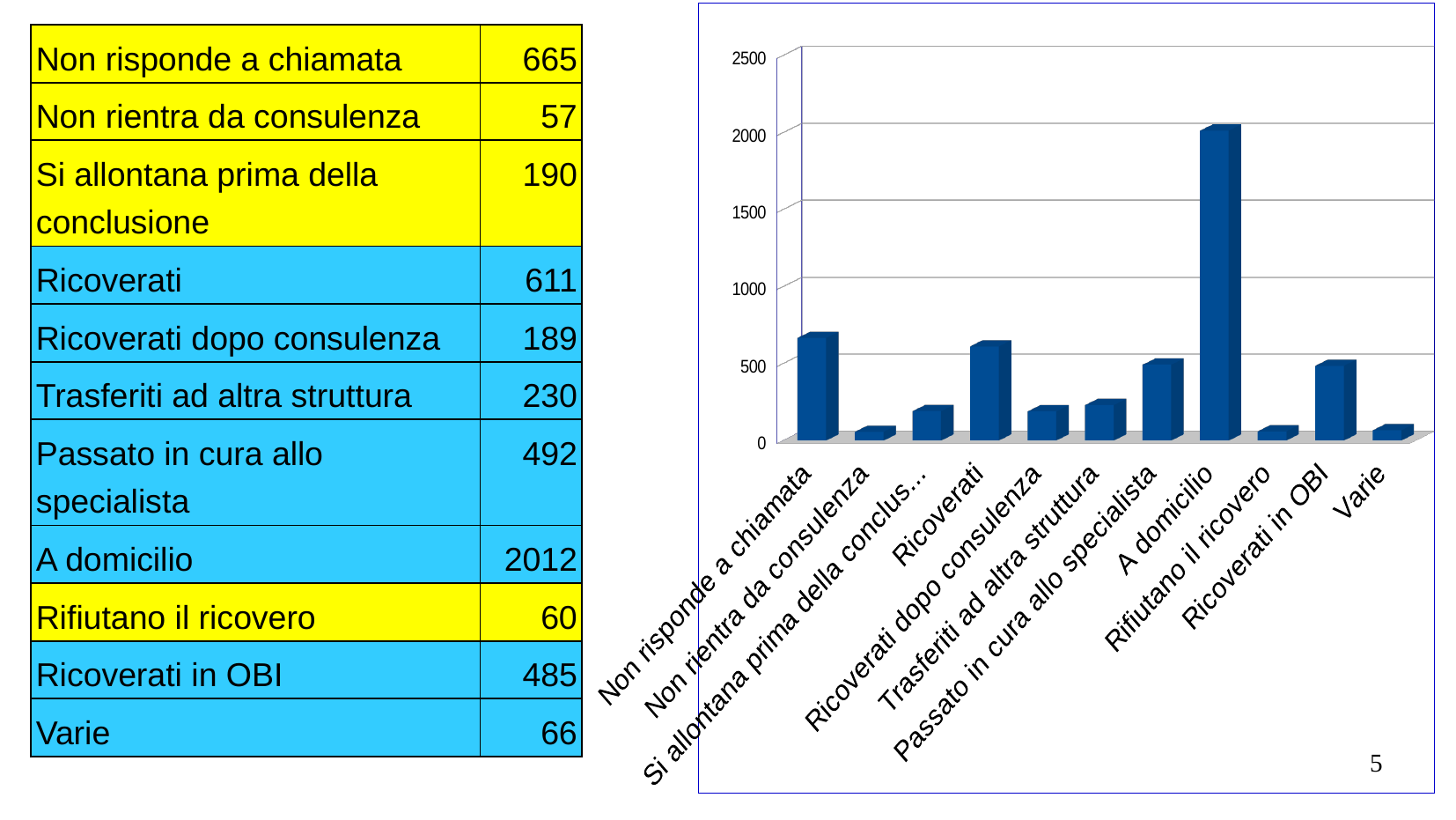
Is the value for A domicilio greater or less than 1500? greater Which is larger, the value for Ricoverati or the value for Passato in cura allo specialista? Ricoverati What is the value for Non risponde a chiamata? 665 What kind of chart is shown on the slide? bar chart What is the value for Ricoverati in OBI? 485 Is the value for Trasferiti ad altra struttura greater or less than 500? less What is the highest value shown on the vertical axis of the bar chart? 2500 What is the difference between the values for A domicilio and Non risponde a chiamata? 1347 What is the value for A domicilio? 2012 How many categories are plotted in the bar chart? 11 Which category has the lowest value in the bar chart? Non rientra da consulenza Which category has the highest value in the bar chart? A domicilio